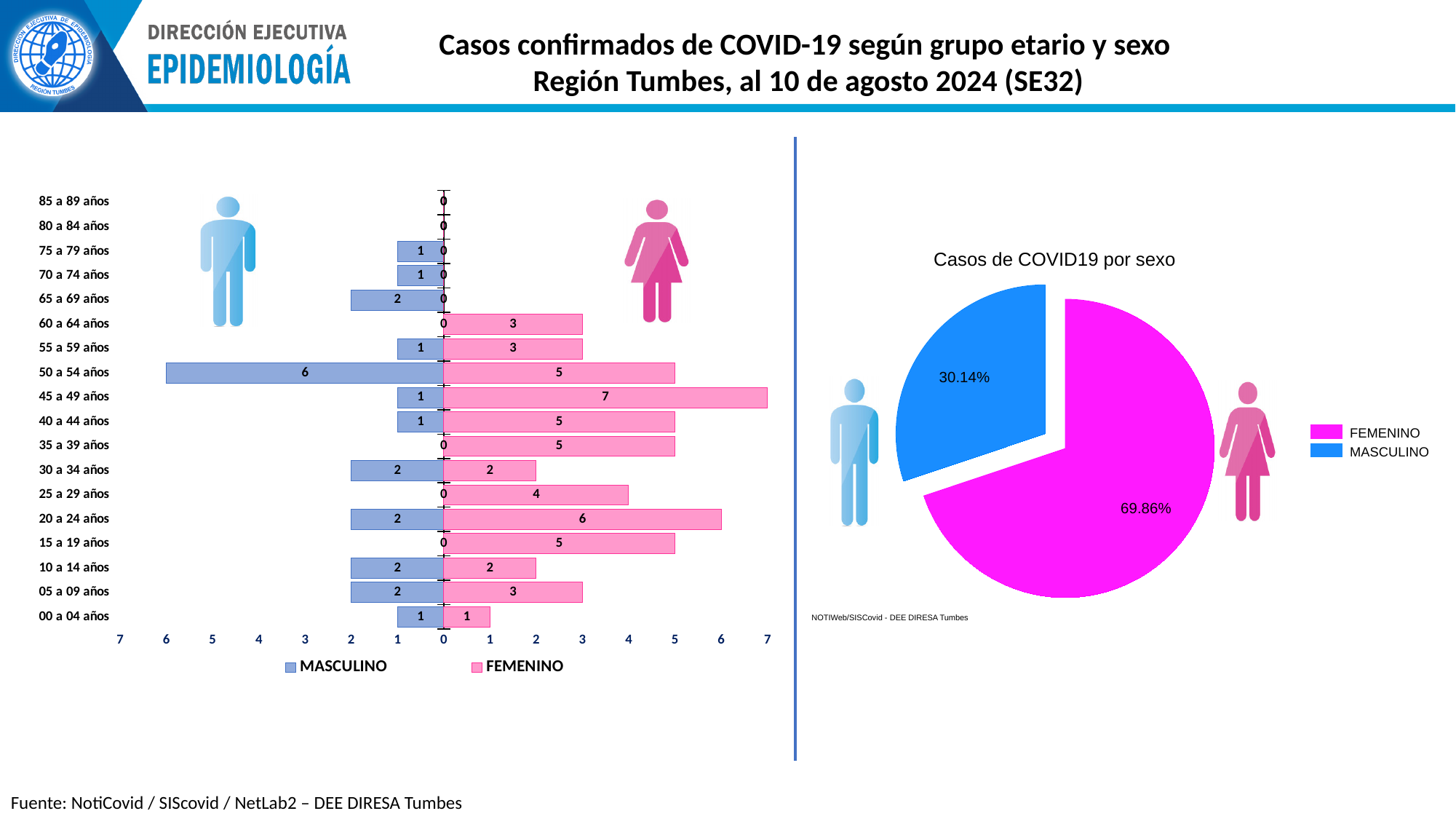
What kind of chart is the chart on the left of the slide? Bar chart In the pie chart 'Casos de COVID19 por sexo', what share is FEMENINO? 69.86% In the left chart (age pyramid), what is the FEMENINO value for the 45 a 49 años group? 7 In the left chart (age pyramid), which age group has the highest FEMENINO value? 45 a 49 años In the left chart (age pyramid), how many age groups are shown? 18 In the left chart (age pyramid), what is the FEMENINO value for the 20 a 24 años group? 6 In the left chart (age pyramid), how many series does the legend list? 2 In the left chart (age pyramid), what is the difference between the FEMENINO and MASCULINO values for the 45 a 49 años group? 6 In the left chart (age pyramid), which is larger for the 50 a 54 años group, MASCULINO or FEMENINO? MASCULINO In the left chart (age pyramid), which age group has the highest MASCULINO value? 50 a 54 años In the left chart (age pyramid), what is the MASCULINO value for the 50 a 54 años group? 6 In the pie chart 'Casos de COVID19 por sexo', what share is MASCULINO? 30.14%